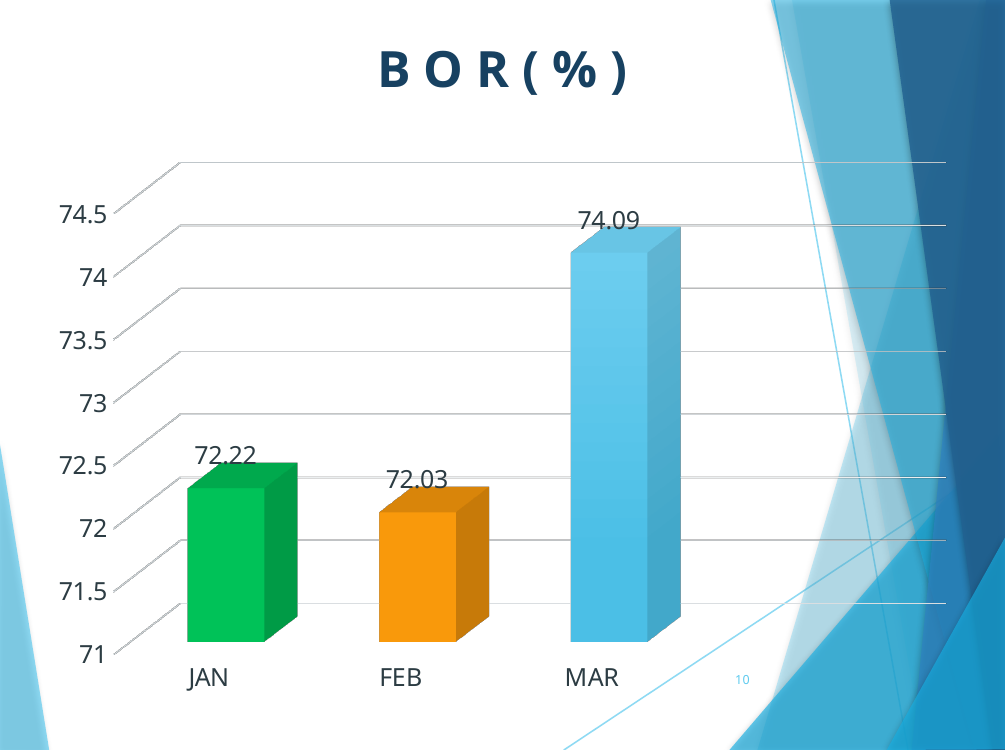
How many months are shown on the chart? 3 What is the BOR (%) value for JAN? 72.22 What is the difference between the BOR (%) values for JAN and FEB? 0.19 Is the value for MAR greater or less than 73? greater What is the difference between the BOR (%) values for MAR and JAN? 1.87 What is the title of the chart? BOR(%) What kind of chart is shown on the slide? Bar chart What is the BOR (%) value for MAR? 74.09 Which month has the highest BOR (%)? MAR Which is larger, the BOR (%) for MAR or for FEB? MAR Which month has the lowest BOR (%)? FEB What is the BOR (%) value for FEB? 72.03